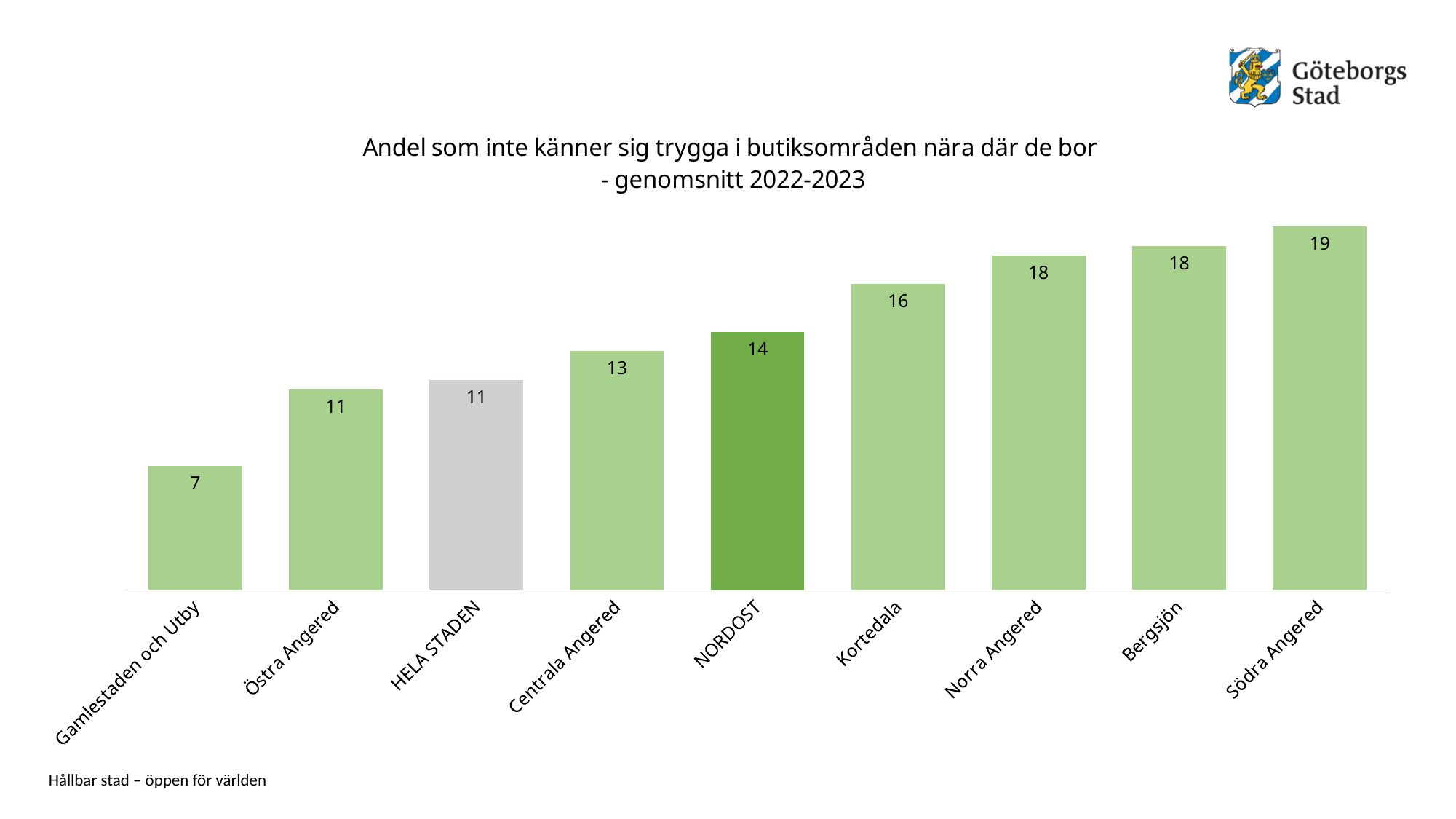
What is the value for Gamlestaden och Utby? 7 What is the value for HELA STADEN? 11 How many categories are shown on the chart? 9 Which is larger, the value for Kortedala or the value for NORDOST? Kortedala What is the difference between the values for Södra Angered and Gamlestaden och Utby? 12 Which category has the highest value? Södra Angered Do the values rise or fall from left to right along the x axis? Rise What kind of chart is shown on the slide? Bar chart Which category has the lowest value? Gamlestaden och Utby What is the value for NORDOST? 14 What is the value for Kortedala? 16 What is the difference between the values for Norra Angered and Centrala Angered? 5